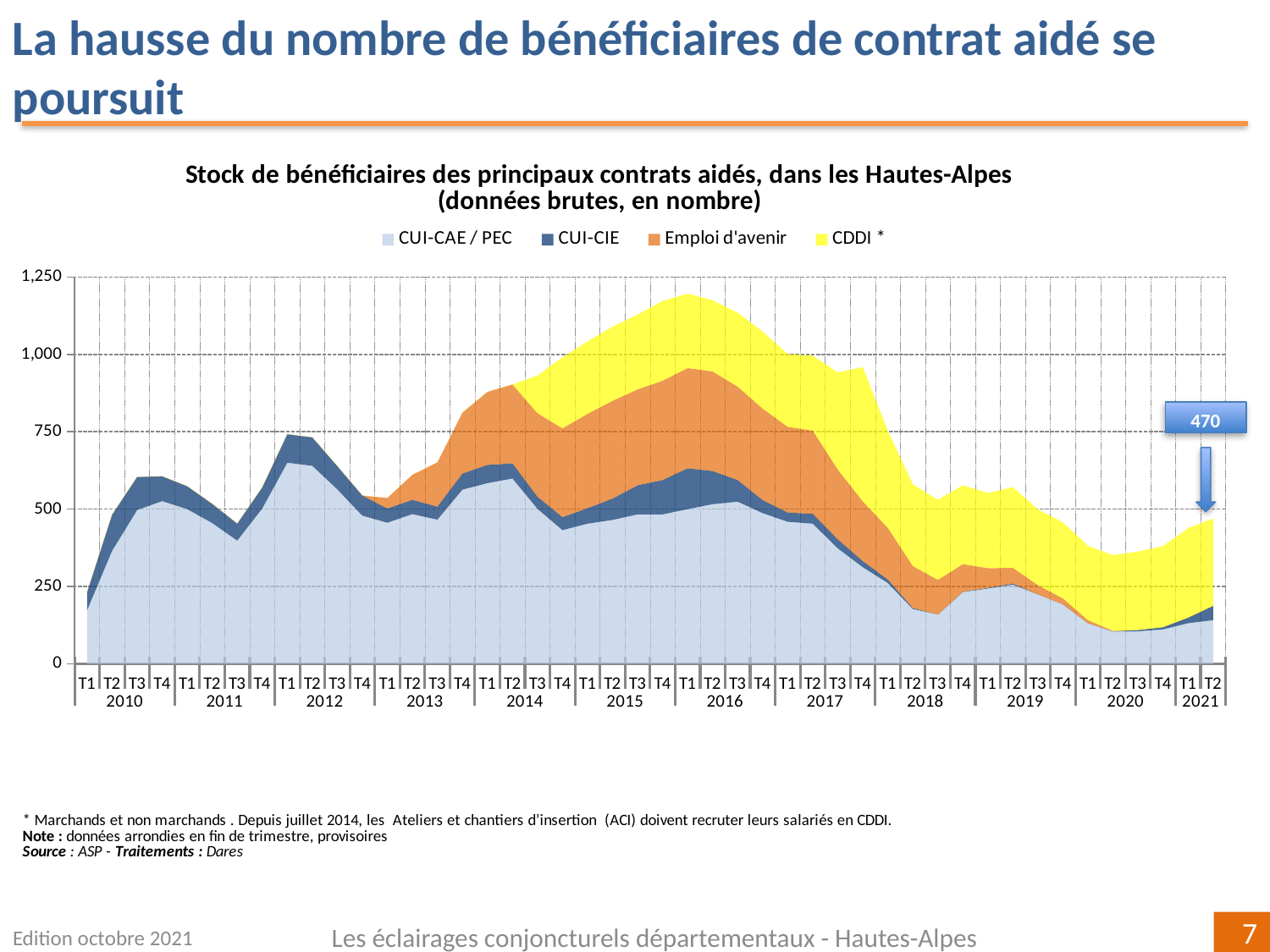
What kind of chart is shown on the slide? Stacked area chart What is the total stock of beneficiaries shown by the data label at T2 2021? 470 How many series does the legend list? 4 Which series is shown in yellow in the chart? CDDI * In which year does the total stock of beneficiaries reach its highest level? 2016 Which is larger, the total stock of beneficiaries at T1 2016 or at T2 2021? T1 2016 Is the total stock of beneficiaries at T2 2020 greater or less than 500? less Is the total stock of beneficiaries at T1 2010 greater or less than 250? less What is the title of the chart? Stock de bénéficiaires des principaux contrats aidés, dans les Hautes-Alpes (données brutes, en nombre) Is the total stock of beneficiaries at T1 2016 greater or less than 1,000? greater Does the total stock of beneficiaries rise or fall between T1 2016 and T2 2020? Fall